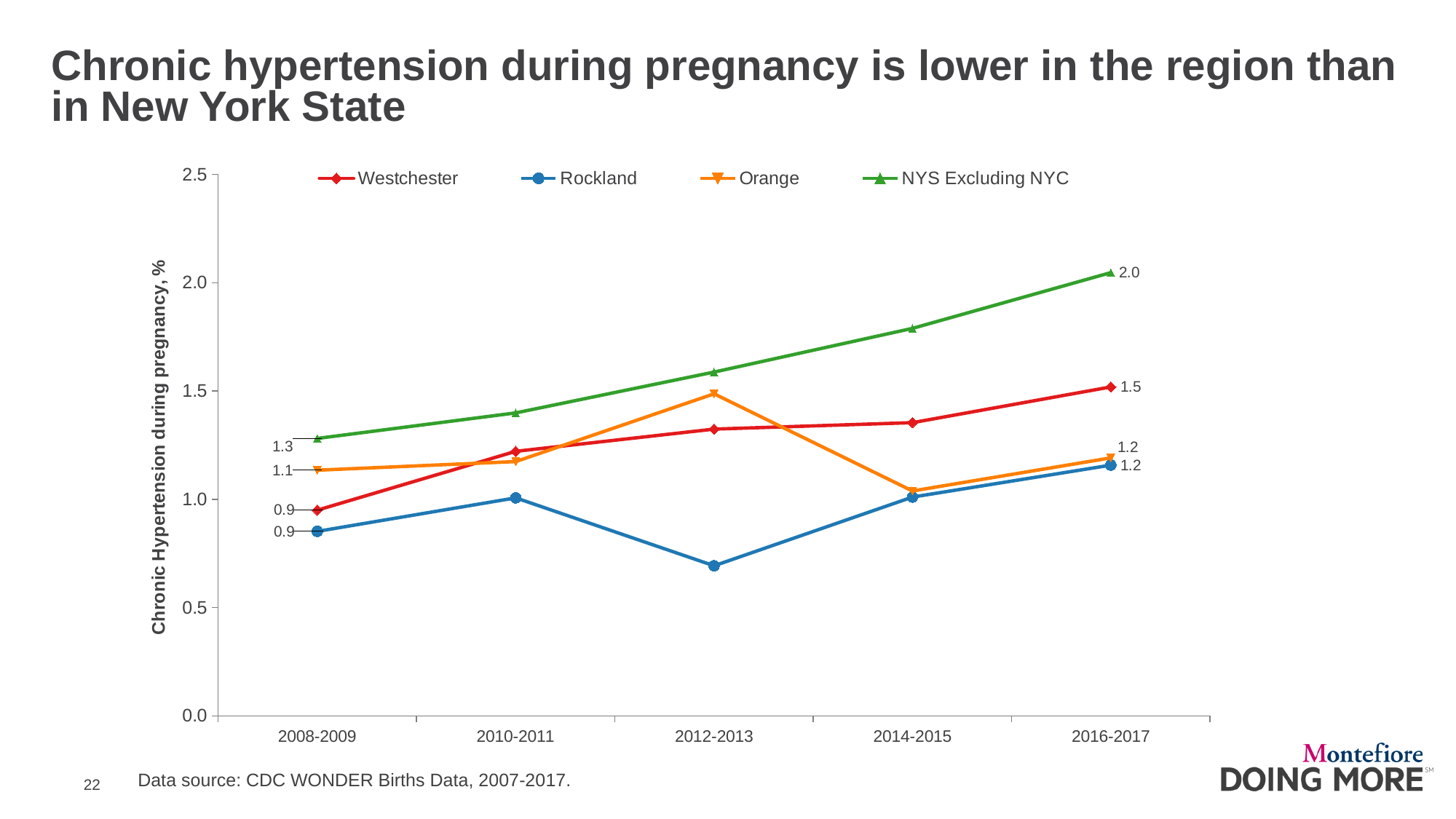
Which series has the highest value in 2016-2017? NYS Excluding NYC Does the NYS Excluding NYC line rise or fall from 2008-2009 to 2016-2017? Rises Which is larger in 2016-2017, Westchester or Rockland? Westchester Is the value for Rockland in 2012-2013 greater or less than 1.0? less How many series does the legend list? 4 What is the difference between NYS Excluding NYC and Westchester in 2016-2017? 0.5 What is the value for Orange in 2008-2009? 1.1 What is the value for Westchester in 2008-2009? 0.9 What is the title of the y axis? Chronic Hypertension during pregnancy, % What kind of chart is shown on the slide? Line chart How many time periods are shown on the x axis? 5 What is the value for NYS Excluding NYC in 2016-2017? 2.0